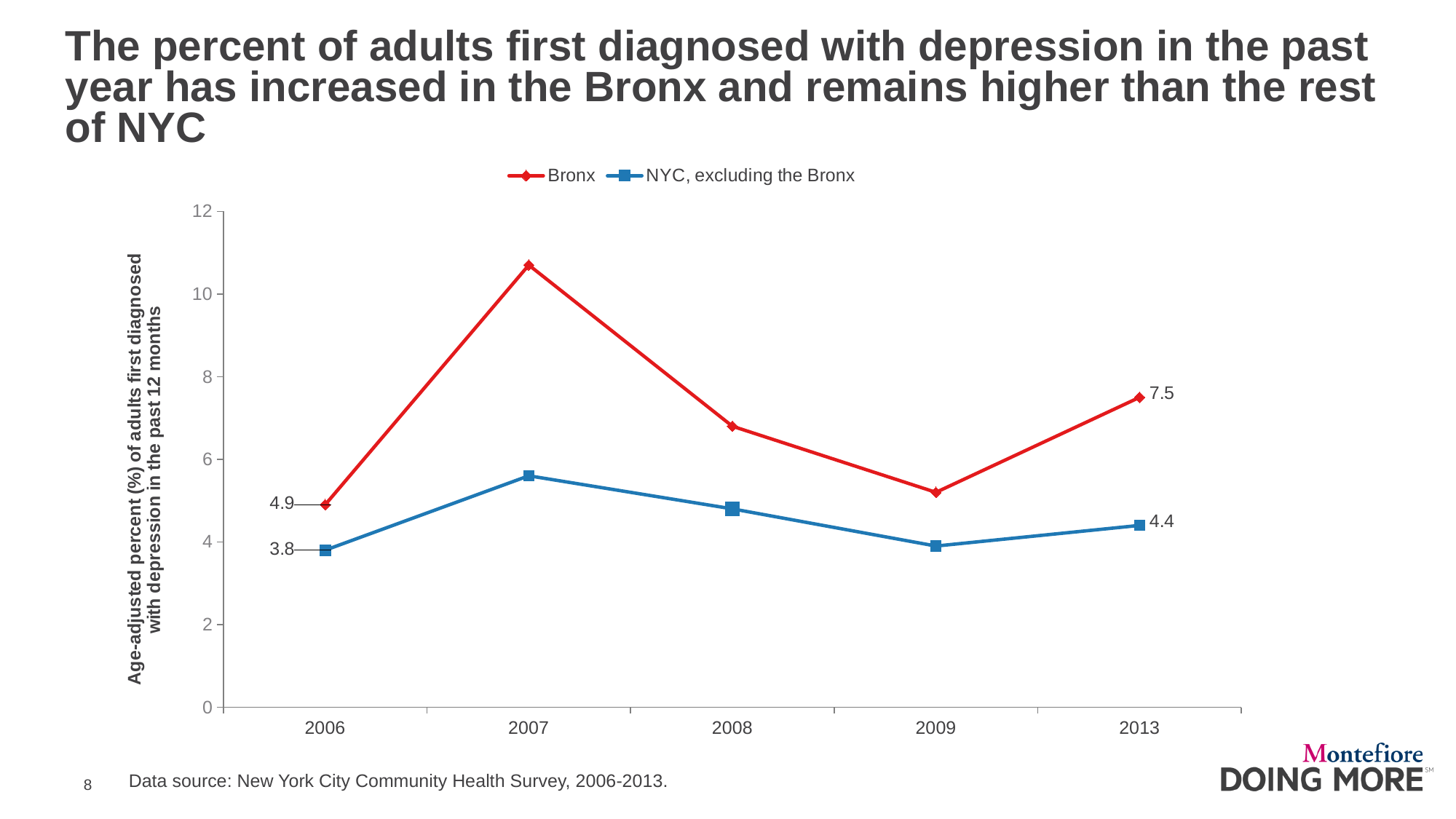
How many series does the legend list? 2 Which series has the higher value in 2008, Bronx or NYC, excluding the Bronx? Bronx What is the difference between the Bronx value in 2013 and the Bronx value in 2006? 2.6 In which year is the Bronx value highest? 2007 In which year is the Bronx value lowest? 2006 What kind of chart is shown on the slide? Line chart What is the value for NYC, excluding the Bronx in 2013? 4.4 What is the difference between the Bronx and NYC, excluding the Bronx values in 2013? 3.1 Is the Bronx value in 2007 greater or less than 10? greater What is the value for NYC, excluding the Bronx in 2006? 3.8 What is the value for the Bronx in 2006? 4.9 What is the value for the Bronx in 2013? 7.5